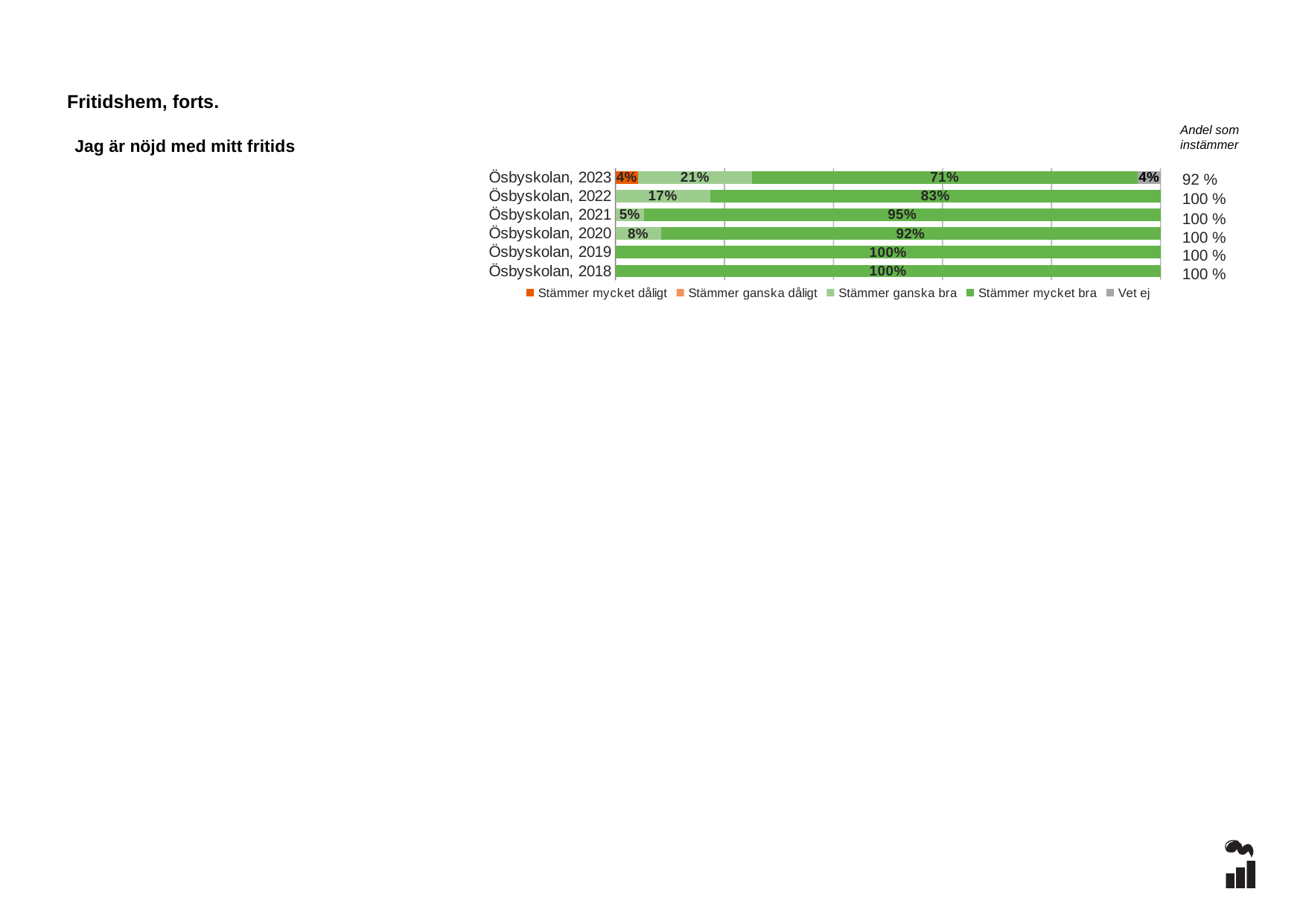
What is the value for "Stämmer mycket bra" for Ösbyskolan, 2023? 71% What is the difference between the "Stämmer mycket bra" values for Ösbyskolan, 2021 and Ösbyskolan, 2022? 12% What is the value for "Stämmer mycket bra" for Ösbyskolan, 2021? 95% What is the "Andel som instämmer" value shown for Ösbyskolan, 2023? 92 % How many categories (bars) does the chart show? 6 What is the value for "Stämmer ganska bra" for Ösbyskolan, 2022? 17% Which category has the lowest value for "Stämmer mycket bra"? Ösbyskolan, 2023 What is the value for "Vet ej" for Ösbyskolan, 2023? 4% What kind of chart is shown on the slide? stacked bar chart How many series does the legend list? 5 Which is larger: the "Stämmer ganska bra" value for Ösbyskolan, 2023 or for Ösbyskolan, 2022? Ösbyskolan, 2023 What is the value for "Stämmer ganska bra" for Ösbyskolan, 2020? 8%